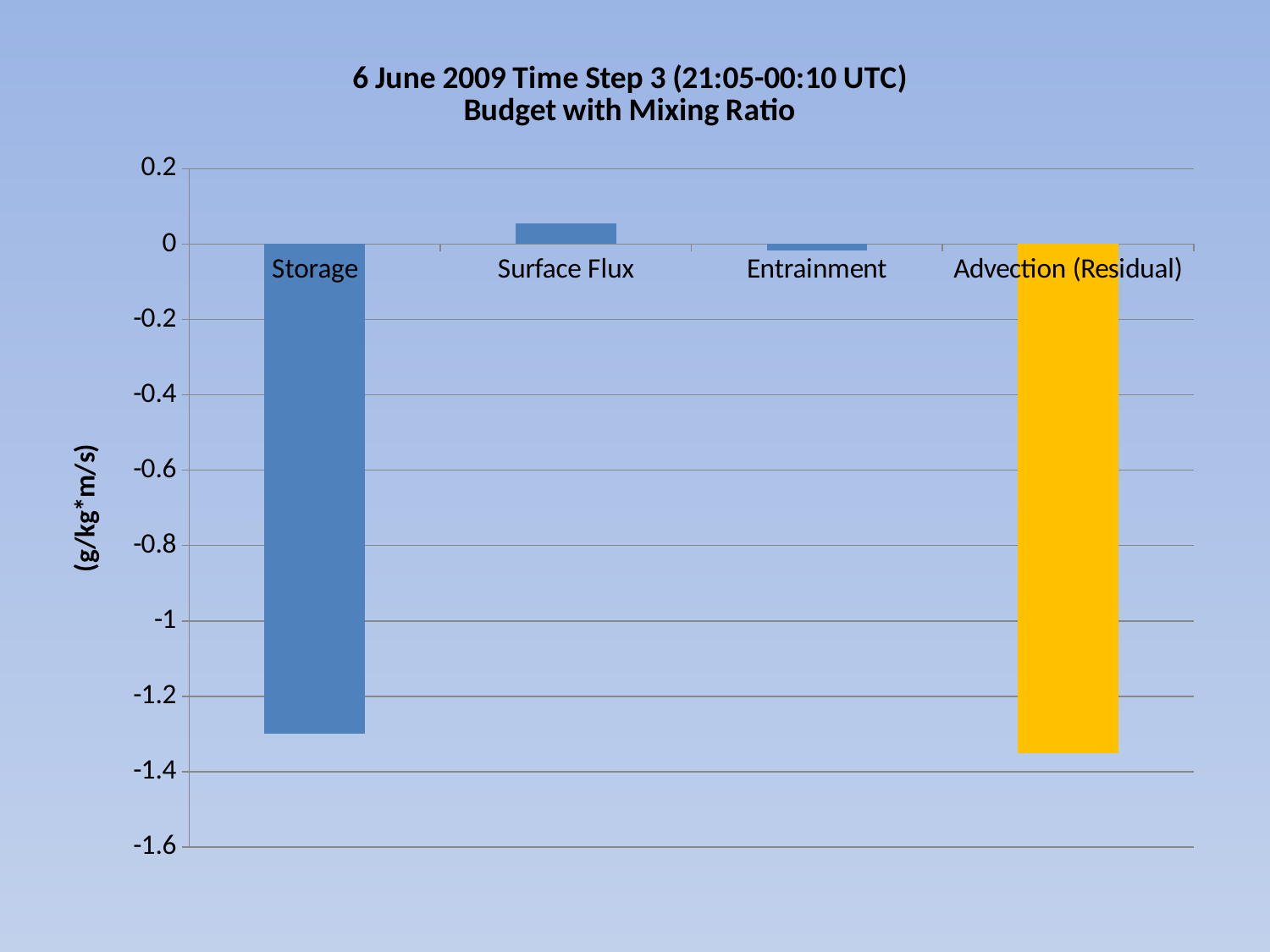
How many categories are plotted on the chart? 4 Is the value for Advection (Residual) greater or less than -1.2? less What unit label is shown on the vertical axis? (g/kg*m/s) Is the value for Entrainment greater or less than 0? less Which category has the lowest value on the chart? Advection (Residual) Which is larger, the value for Surface Flux or the value for Entrainment? Surface Flux Which category has the highest value on the chart? Surface Flux Is the value for Storage greater or less than -1.2? less What is the title of the chart? 6 June 2009 Time Step 3 (21:05-00:10 UTC) Budget with Mixing Ratio What kind of chart is shown on the slide? bar chart